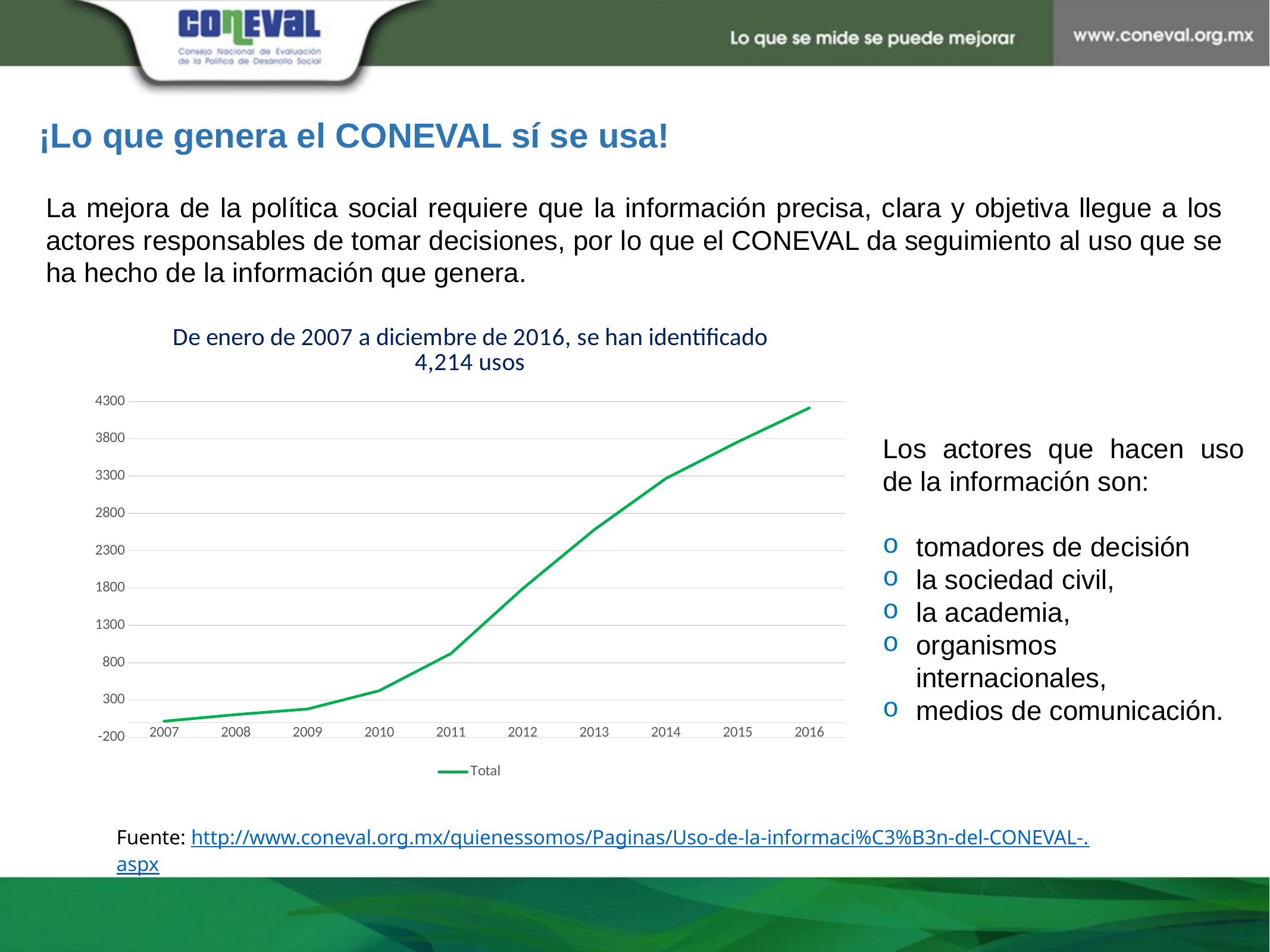
What kind of chart is shown on the slide? line chart Which year has the highest value for Total? 2016 Which year has the lowest value for Total? 2007 How many years are plotted along the x axis of the chart? 10 Is the value for Total in 2014 greater or less than 3800? less How many series does the chart legend list? 1 Is the value for Total in 2016 greater or less than 3800? greater Is the value for Total in 2010 greater or less than 800? less Do the values for Total rise or fall from 2007 to 2016? rise Which year has the larger value for Total, 2012 or 2015? 2015 What is the name of the series shown in the chart legend? Total